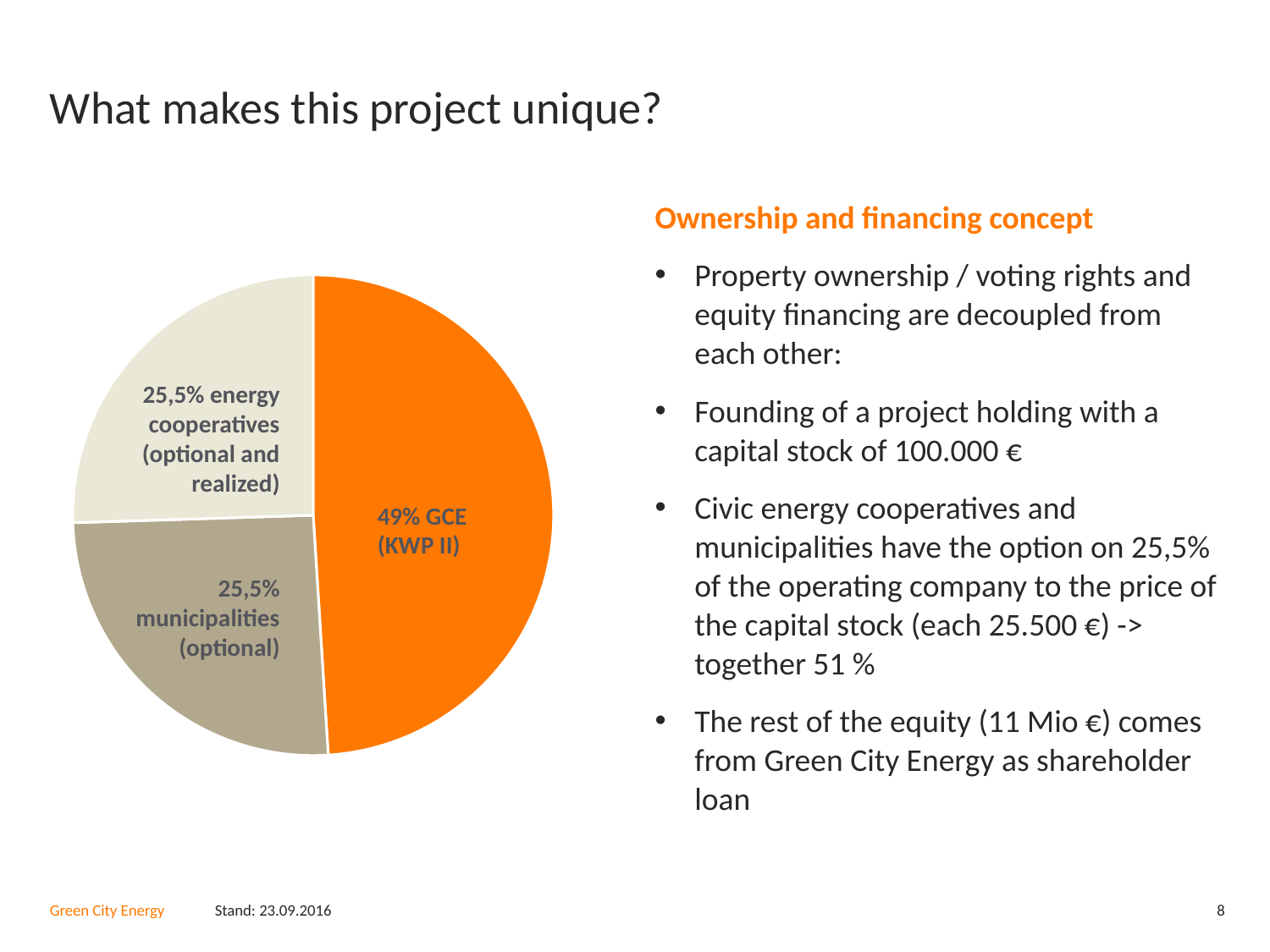
How many slices does the pie chart have? 3 What share of the pie does GCE (KWP II) hold? 49% What share of the pie do the energy cooperatives (optional and realized) hold? 25,5% What colour is the GCE (KWP II) slice? orange What share of the pie do the municipalities (optional) hold? 25,5% What kind of chart is shown on the slide? pie chart Which is larger: the GCE (KWP II) slice or the municipalities (optional) slice? GCE (KWP II) Is the share for GCE (KWP II) greater or less than 50%? less Which slice of the pie chart is the largest? 49% GCE (KWP II) What is the difference between the GCE (KWP II) share and the municipalities (optional) share? 23,5% What is the heading of the text section next to the pie chart? Ownership and financing concept What is the combined share of the energy cooperatives and municipalities slices? 51%